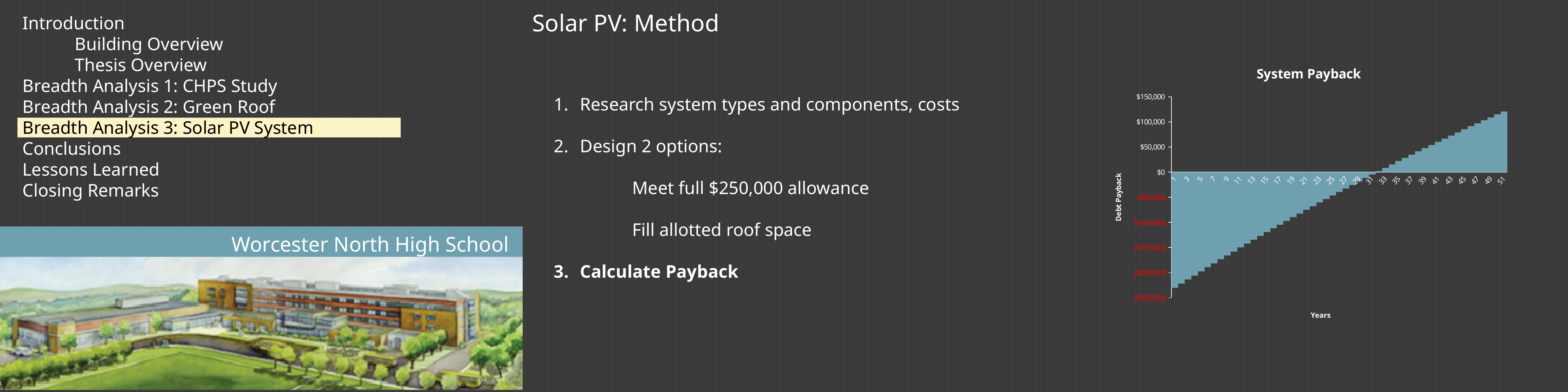
On the System Payback chart, is the value for year 45 greater or less than $50,000? greater On the System Payback chart, which is larger, the value for year 51 or the value for year 1? year 51 On the System Payback chart, is the value for year 51 greater or less than $100,000? greater On the System Payback chart, do the values rise or fall as the years increase along the x axis? rise What kind of chart is the System Payback chart? bar chart On the System Payback chart, which year has the lowest value? 1 On the System Payback chart, is the value for year 37 greater or less than $0? greater What is the title of the chart on the slide? System Payback What is the label of the vertical axis on the System Payback chart? Debt Payback On the System Payback chart, which year has the highest value? 51